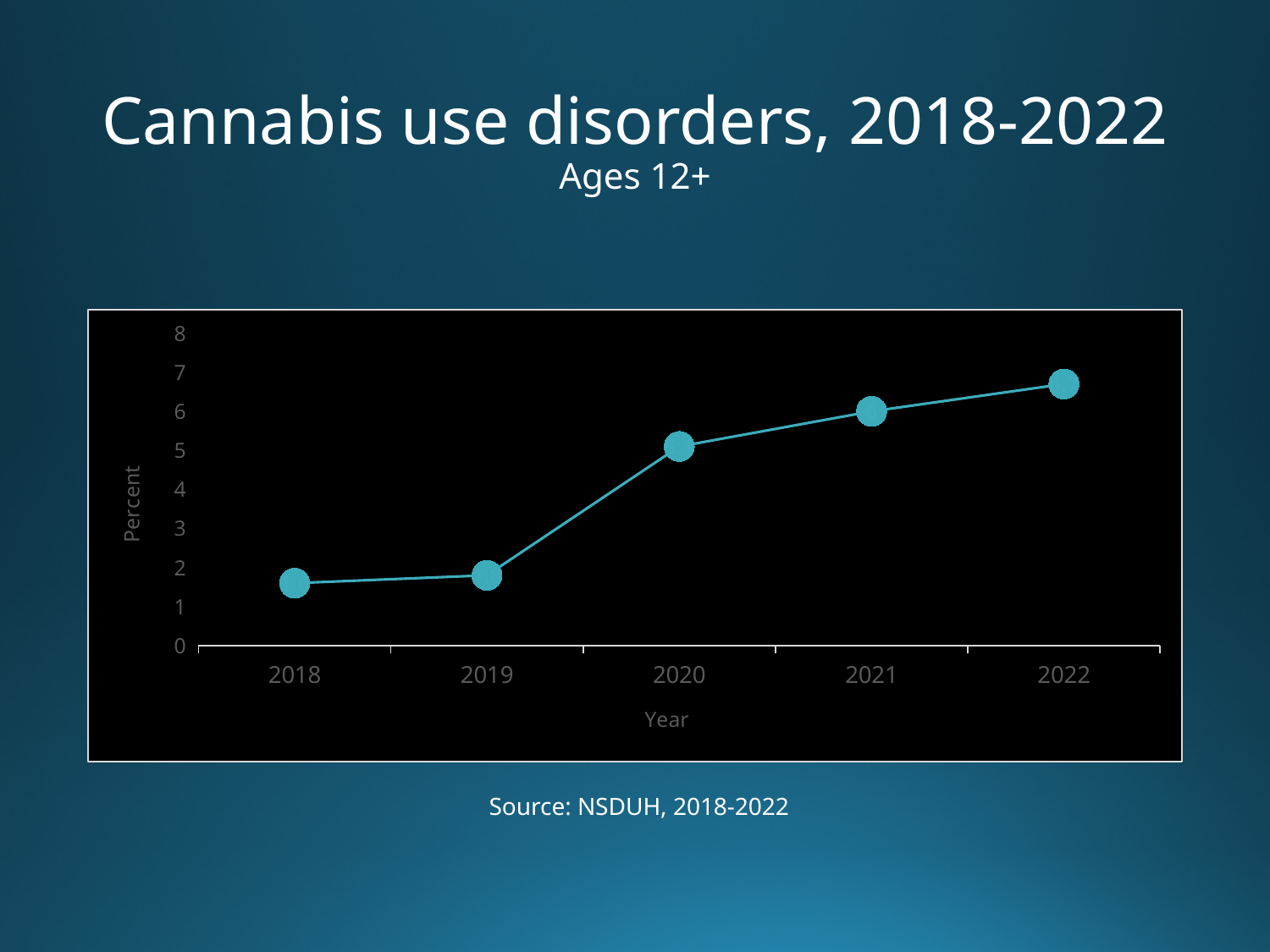
What kind of chart is shown on the slide? line chart Is the value for 2018 greater or less than 2? less What is the title of the chart on the slide? Cannabis use disorders, 2018-2022 How many years are plotted on the chart? 5 Do the values rise or fall from 2018 to 2022? rise Is the value for 2019 greater or less than 3? less Which year has the highest percentage of cannabis use disorders? 2022 Which year has the larger value, 2019 or 2020? 2020 Is the value for 2022 greater or less than 7? less What is the label on the vertical axis of the chart? Percent